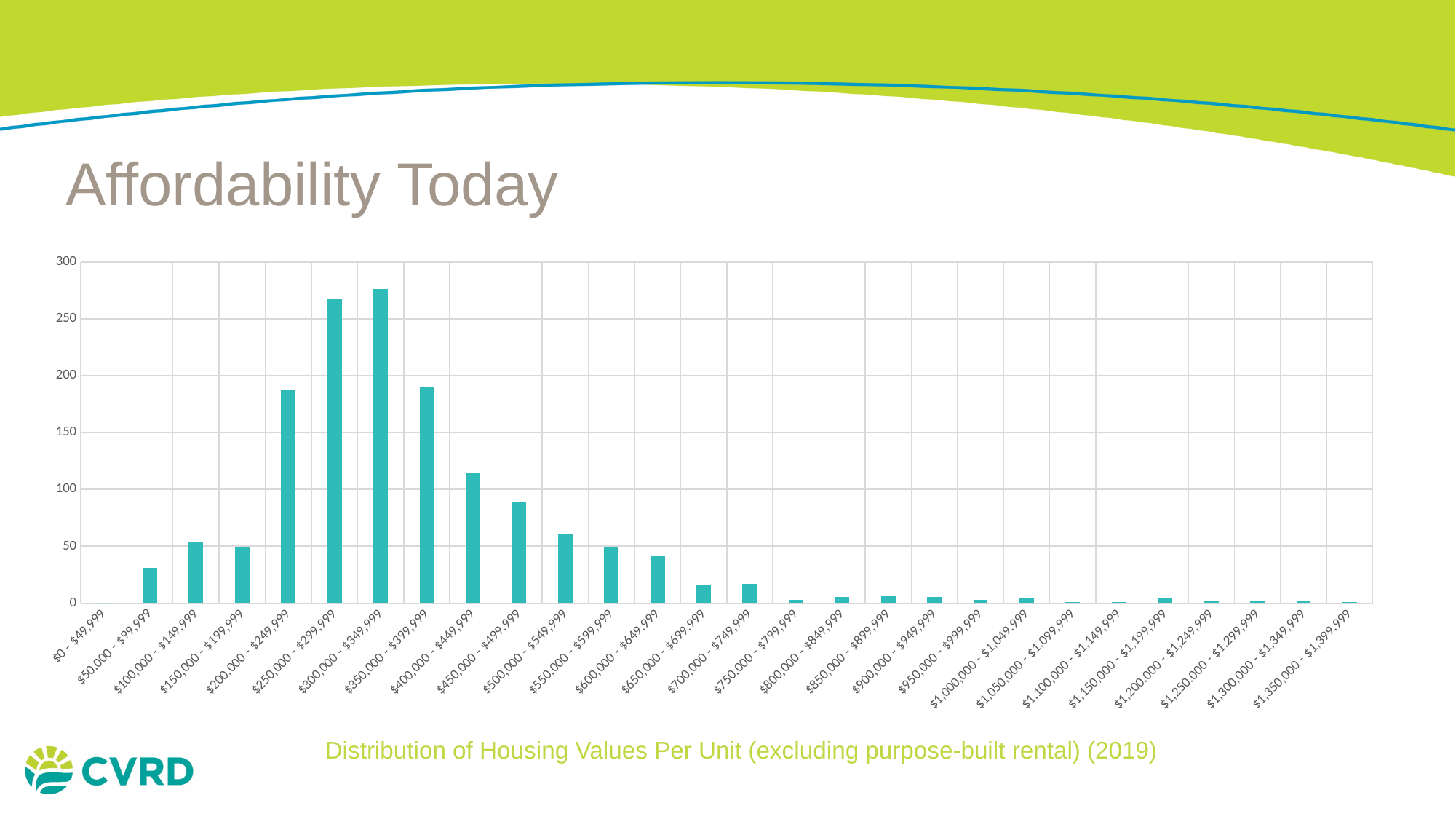
Is the value for $350,000 - $399,999 greater or less than 200? less Is the value for $50,000 - $99,999 greater or less than 50? less Do the values generally rise or fall along the x axis from $300,000 - $349,999 to $1,350,000 - $1,399,999? Fall What is the caption/title given for the chart? Distribution of Housing Values Per Unit (excluding purpose-built rental) (2019) Is the value for $400,000 - $449,999 greater or less than 100? greater Which is larger, the value for $400,000 - $449,999 or the value for $650,000 - $699,999? $400,000 - $449,999 Which is larger, the value for $550,000 - $599,999 or the value for $600,000 - $649,999? $550,000 - $599,999 How many housing value categories are shown on the x axis? 28 What kind of chart is shown on the slide? Bar chart Which housing value category has the highest bar? $300,000 - $349,999